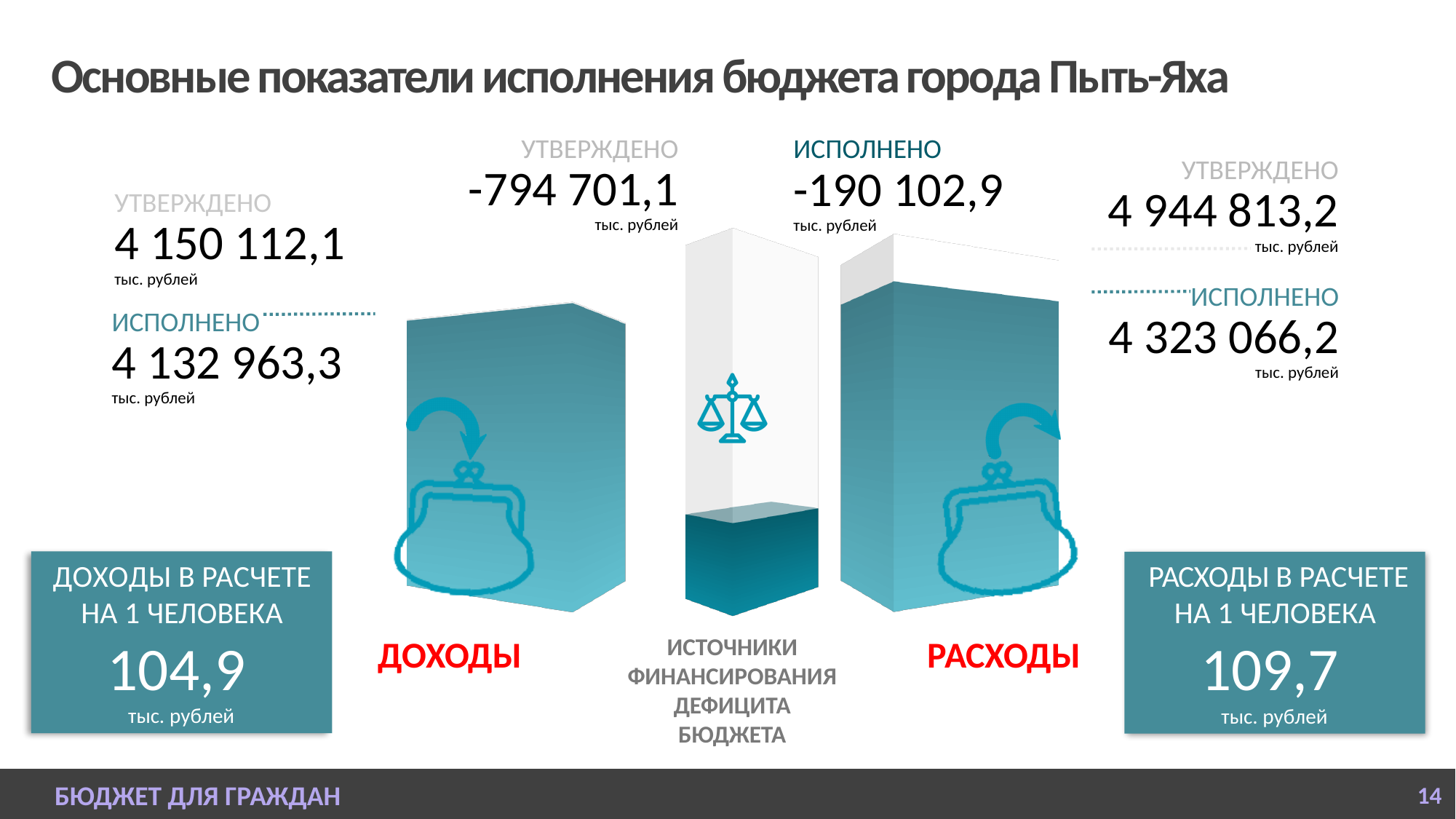
What is the executed (ИСПОЛНЕНО) value for ИСТОЧНИКИ ФИНАНСИРОВАНИЯ ДЕФИЦИТА БЮДЖЕТА? -190 102,9 тыс. рублей Which is larger: the executed value for ДОХОДЫ or the executed value for РАСХОДЫ? РАСХОДЫ What is the difference between the approved and executed values for РАСХОДЫ? 621 747,0 тыс. рублей What is the approved (УТВЕРЖДЕНО) value for РАСХОДЫ? 4 944 813,2 тыс. рублей What is the approved (УТВЕРЖДЕНО) value for ИСТОЧНИКИ ФИНАНСИРОВАНИЯ ДЕФИЦИТА БЮДЖЕТА? -794 701,1 тыс. рублей How many budget indicators (blocks) are shown on the slide? 3 What is the difference between the approved and executed values for ДОХОДЫ? 17 148,8 тыс. рублей What are the revenues per person (ДОХОДЫ В РАСЧЕТЕ НА 1 ЧЕЛОВЕКА)? 104,9 тыс. рублей What are the expenses per person (РАСХОДЫ В РАСЧЕТЕ НА 1 ЧЕЛОВЕКА)? 109,7 тыс. рублей What is the executed (ИСПОЛНЕНО) value for ДОХОДЫ? 4 132 963,3 тыс. рублей What is the approved (УТВЕРЖДЕНО) value for ДОХОДЫ? 4 150 112,1 тыс. рублей What is the executed (ИСПОЛНЕНО) value for РАСХОДЫ? 4 323 066,2 тыс. рублей